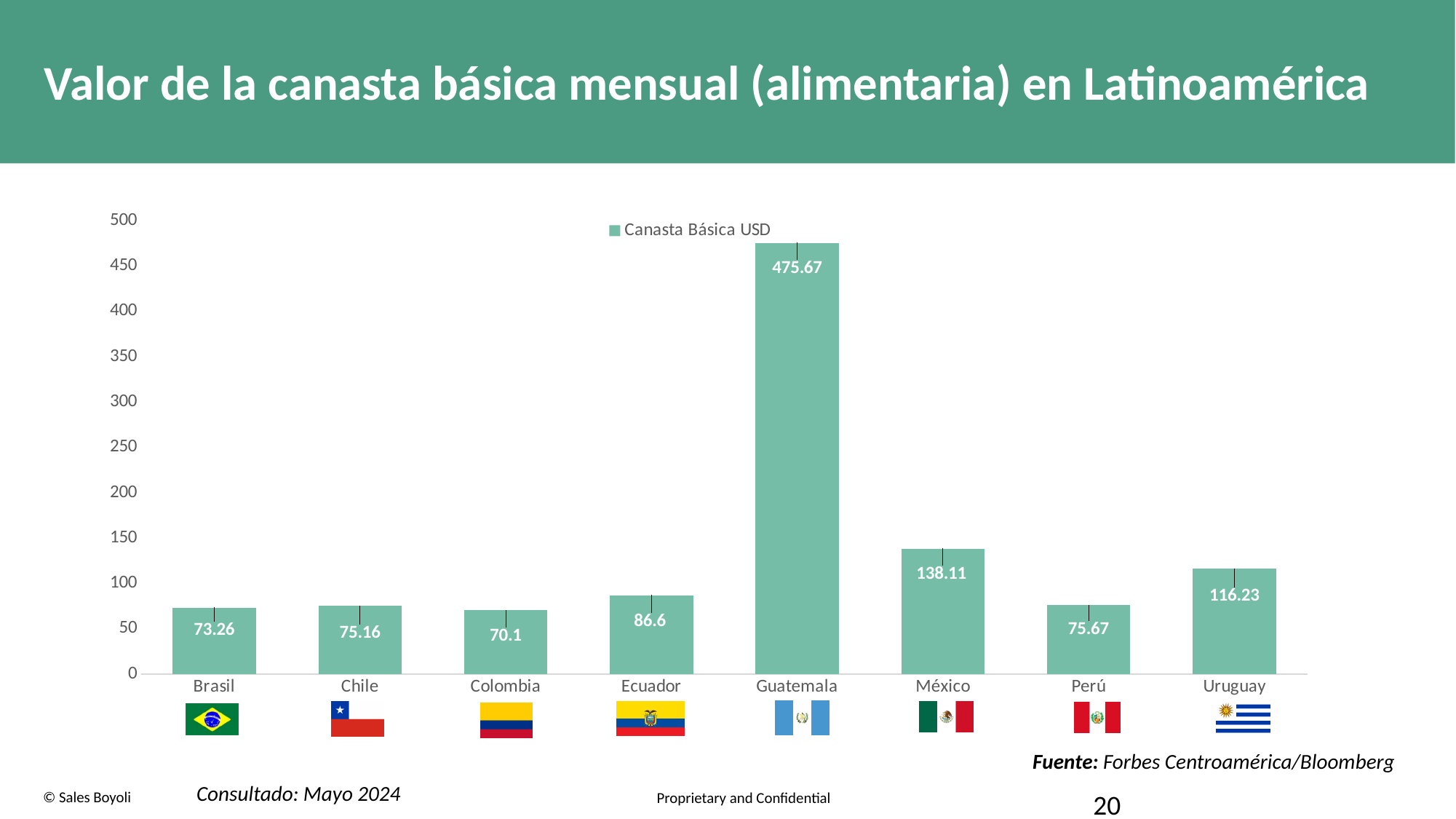
What kind of chart is shown on the slide? Bar chart What is the legend entry of the series shown on the chart? Canasta Básica USD What is the value for Guatemala? 475.67 Which country has the lowest value? Colombia Which country has the highest value? Guatemala What is the difference between the values for Guatemala and México? 337.56 Which is larger, the value for Ecuador or the value for Brasil? Ecuador What is the value for Colombia? 70.1 What is the difference between the values for Uruguay and Ecuador? 29.63 What is the value for México? 138.11 How many countries are shown on the chart? 8 Is the value for Uruguay greater or less than 100? greater